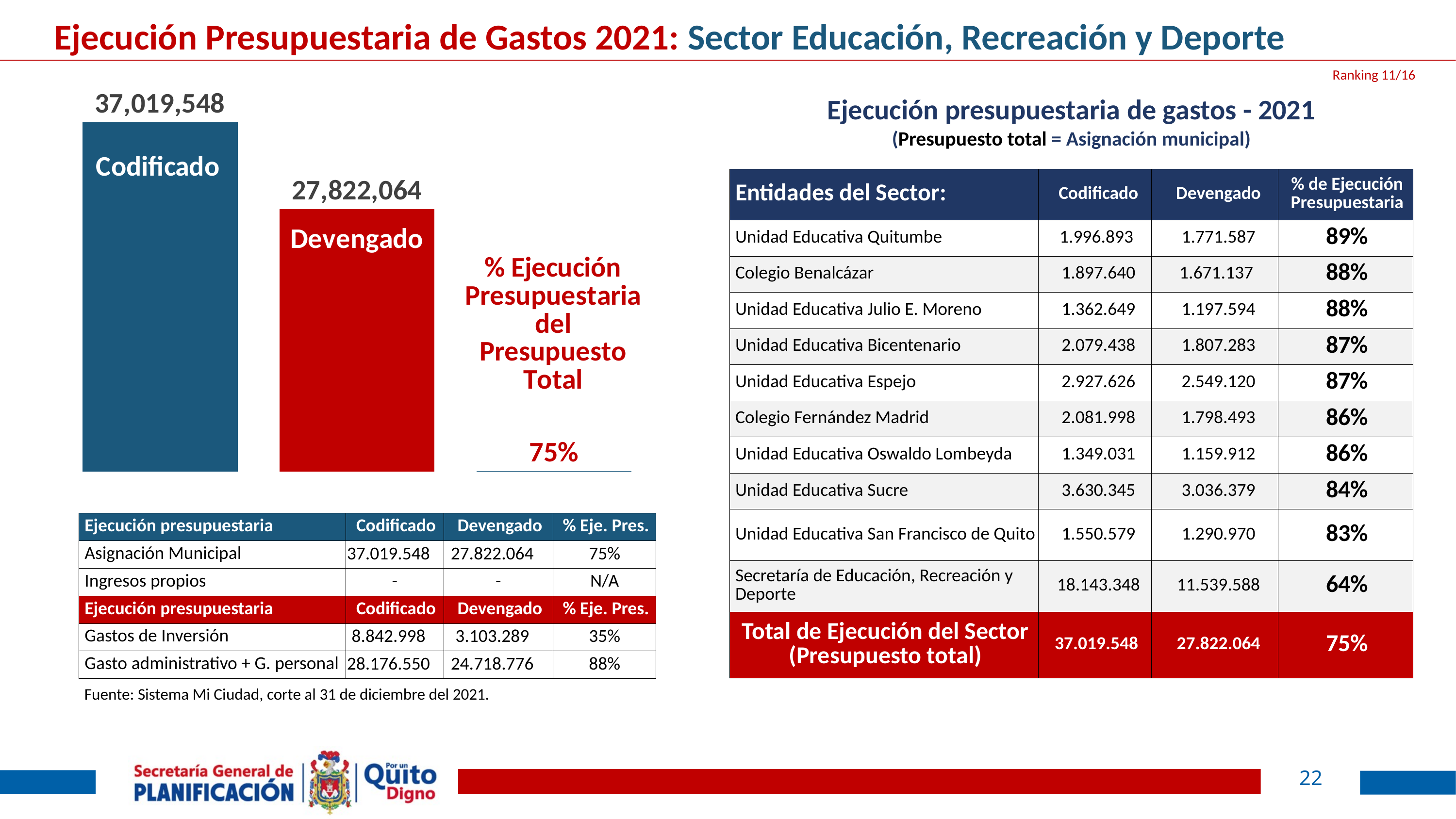
How many bars are plotted in the chart? 2 Which is larger, Codificado or Devengado? Codificado What percentage is shown next to the chart as the % Ejecución Presupuestaria del Presupuesto Total? 75% What colour is the Devengado bar? Red What is the difference between the Codificado and Devengado bars? 9,197,484 Which bar is the highest in the chart? Codificado What is the value of the Codificado bar? 37,019,548 What is the value of the Devengado bar? 27,822,064 Which bar is the lowest in the chart? Devengado What kind of chart is shown on the slide? Bar chart